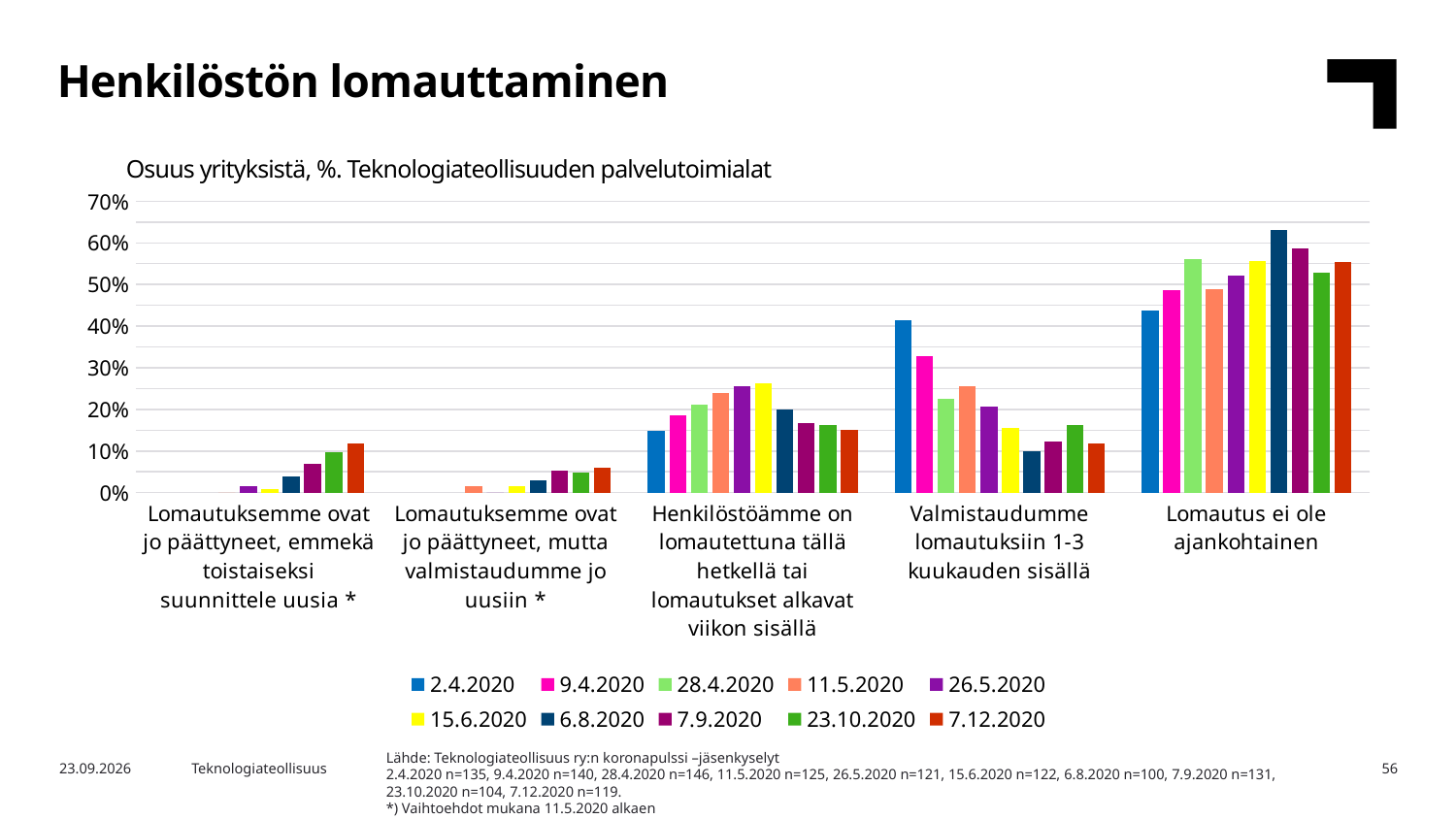
For the category 'Valmistaudumme lomautuksiin 1-3 kuukauden sisällä', do the values rise or fall from 2.4.2020 to 6.8.2020? fall Is the value for 2.4.2020 in the category 'Valmistaudumme lomautuksiin 1-3 kuukauden sisällä' greater or less than 30%? greater In the category 'Henkilöstöämme on lomautettuna tällä hetkellä tai lomautukset alkavat viikon sisällä', which is larger: the value for 2.4.2020 or for 26.5.2020? 26.5.2020 Is the value for 7.12.2020 in the category 'Lomautuksemme ovat jo päättyneet, emmekä toistaiseksi suunnittele uusia *' greater or less than 10%? greater For the category 'Lomautuksemme ovat jo päättyneet, emmekä toistaiseksi suunnittele uusia *', which survey date has the highest value? 7.12.2020 For the category 'Lomautus ei ole ajankohtainen', which survey date has the highest value? 6.8.2020 What kind of chart is shown on the slide? Bar chart How many series (survey dates) does the legend list? 10 How many response categories are shown on the x axis? 5 For the category 'Valmistaudumme lomautuksiin 1-3 kuukauden sisällä', which survey date has the highest value? 2.4.2020 In the category 'Lomautus ei ole ajankohtainen', which is larger: the value for 2.4.2020 or for 7.12.2020? 7.12.2020 Is the value for 6.8.2020 in the category 'Lomautus ei ole ajankohtainen' greater or less than 60%? greater